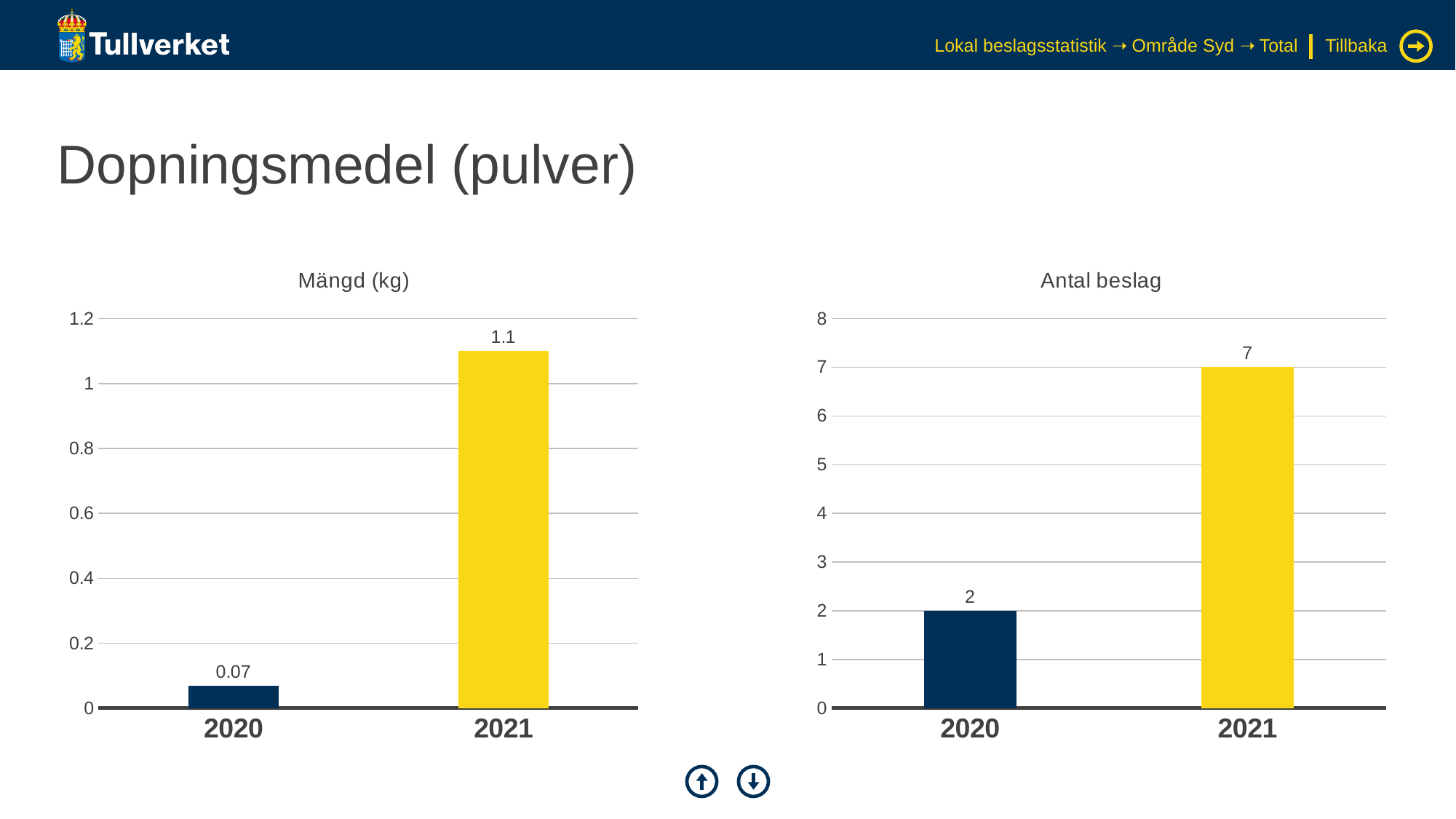
In the 'Antal beslag' chart, what is the difference between the values for 2021 and 2020? 5 In the 'Mängd (kg)' chart, what is the value for 2020? 0.07 How many categories are shown on the x axis of the 'Antal beslag' chart? 2 In the 'Mängd (kg)' chart, which year has the lowest value? 2020 In the 'Antal beslag' chart, do the values rise or fall from 2020 to 2021? Rise In the 'Antal beslag' chart, which year has the highest value? 2021 In the 'Antal beslag' chart, what is the value for 2020? 2 What kind of chart is the 'Mängd (kg)' chart? Bar chart In the 'Mängd (kg)' chart, is the value for 2021 greater or less than 1? greater In the 'Mängd (kg)' chart, what is the value for 2021? 1.1 In the 'Mängd (kg)' chart, is the value for 2021 larger than the value for 2020? Yes In the 'Antal beslag' chart, what is the value for 2021? 7